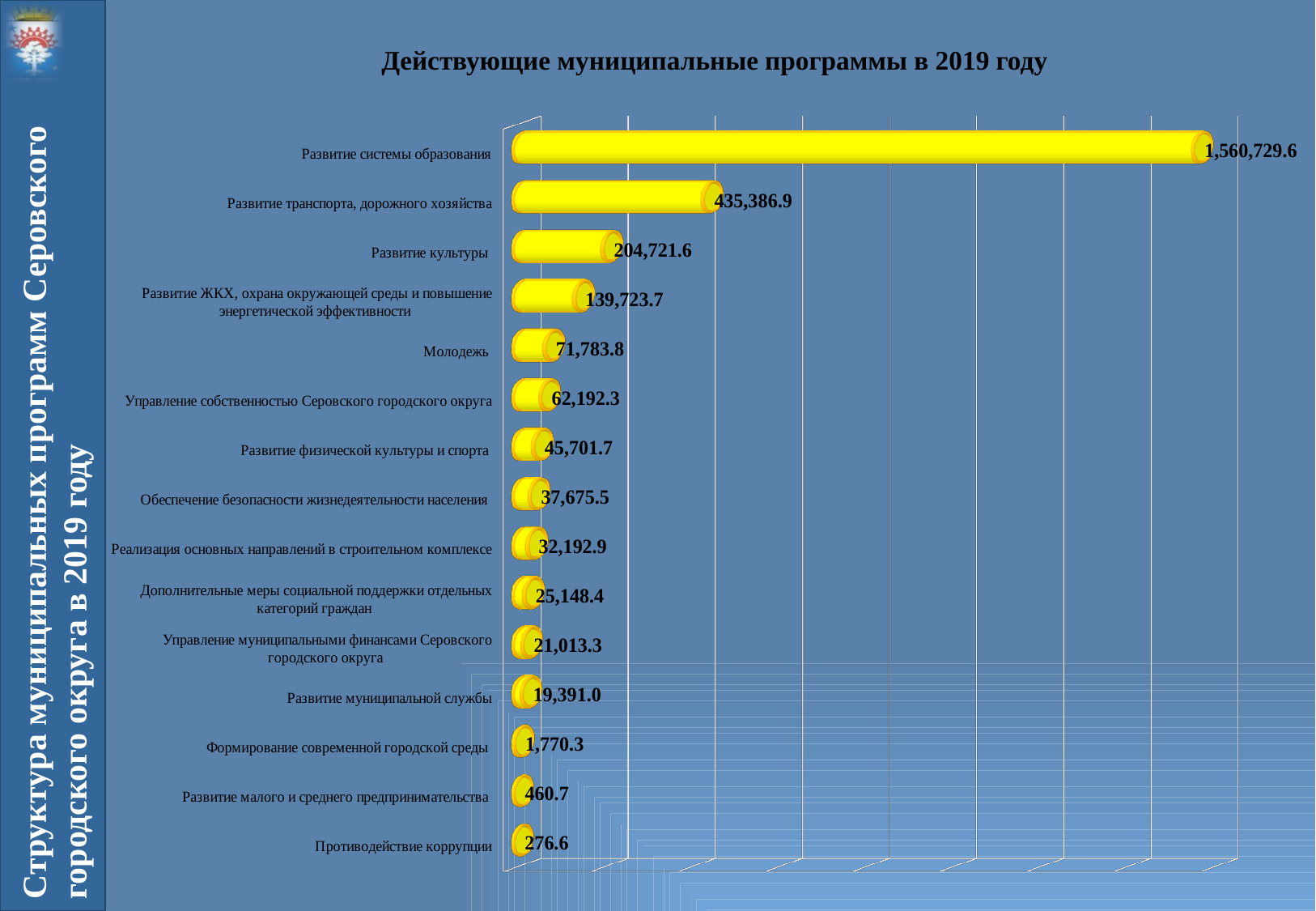
What is the value for Развитие системы образования? 1,560,729.6 Which is larger: Развитие физической культуры и спорта or Обеспечение безопасности жизнедеятельности населения? Развитие физической культуры и спорта Which category has the highest value? Развитие системы образования What is the difference between Формирование современной городской среды and Развитие малого и среднего предпринимательства? 1,309.6 What is the title of the chart? Действующие муниципальные программы в 2019 году How many categories are shown in the chart? 15 What kind of chart is shown on the slide? Bar chart What is the value for Развитие транспорта, дорожного хозяйства? 435,386.9 What is the value for Противодействие коррупции? 276.6 Which category has the lowest value? Противодействие коррупции What is the difference between Развитие транспорта, дорожного хозяйства and Развитие культуры? 230,665.3 What is the value for Молодежь? 71,783.8